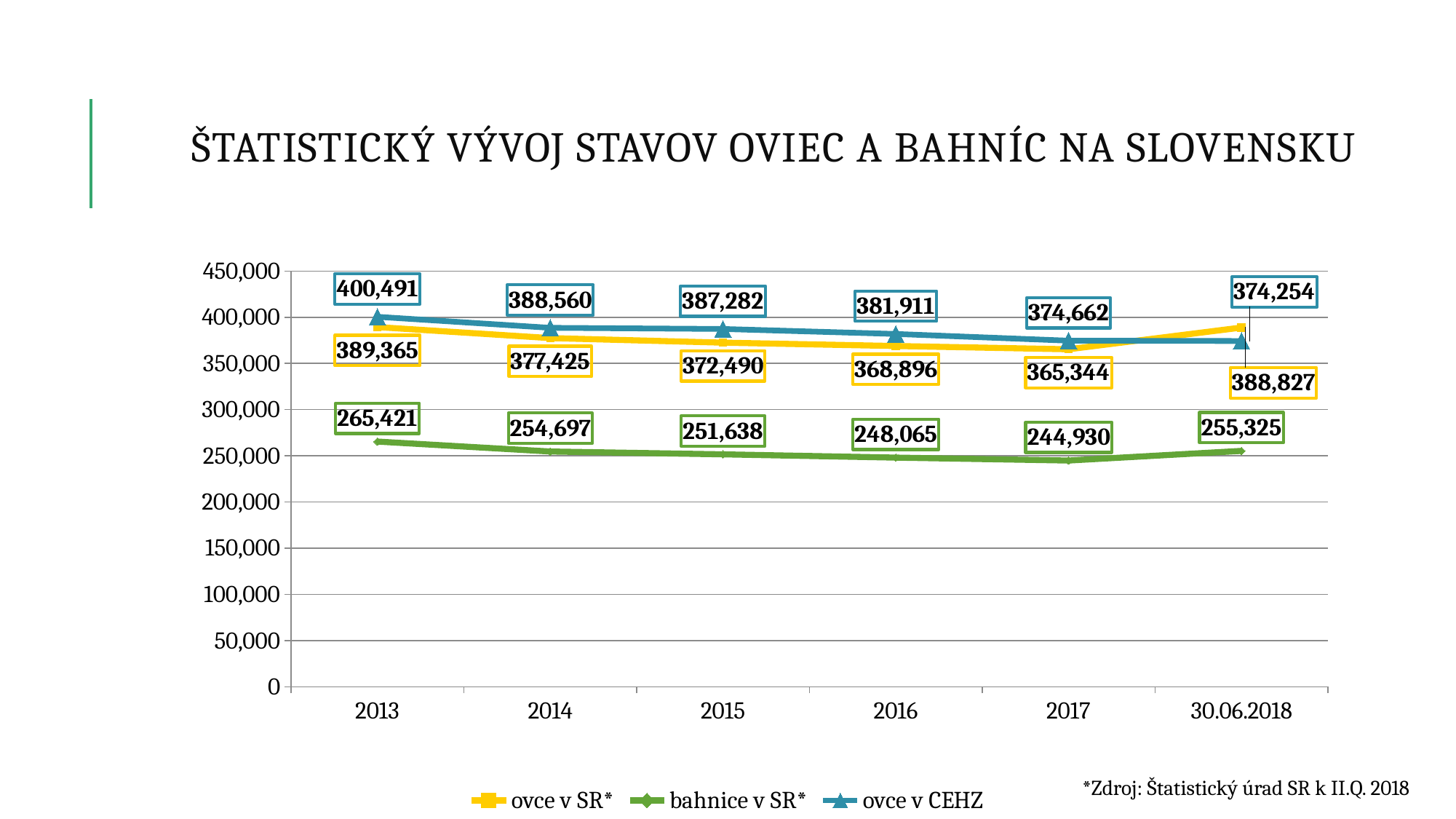
What is the title of the chart on the slide? ŠTATISTICKÝ VÝVOJ STAVOV OVIEC A BAHNÍC NA SLOVENSKU Does the value for bahnice v SR* rise or fall from 2013 to 2017? fall In which year is the value for ovce v CEHZ highest? 2013 What is the difference between ovce v CEHZ and ovce v SR* in 2014? 11,135 What kind of chart is shown on the slide? line chart What is the value for ovce v CEHZ in 2013? 400,491 In which year is the value for bahnice v SR* lowest? 2017 How many points along the x axis does the chart have? 6 How many series does the legend list? 3 What is the value for bahnice v SR* in 2016? 248,065 What is the value for ovce v SR* at 30.06.2018? 388,827 Which is larger in 2017: ovce v SR* or ovce v CEHZ? ovce v CEHZ